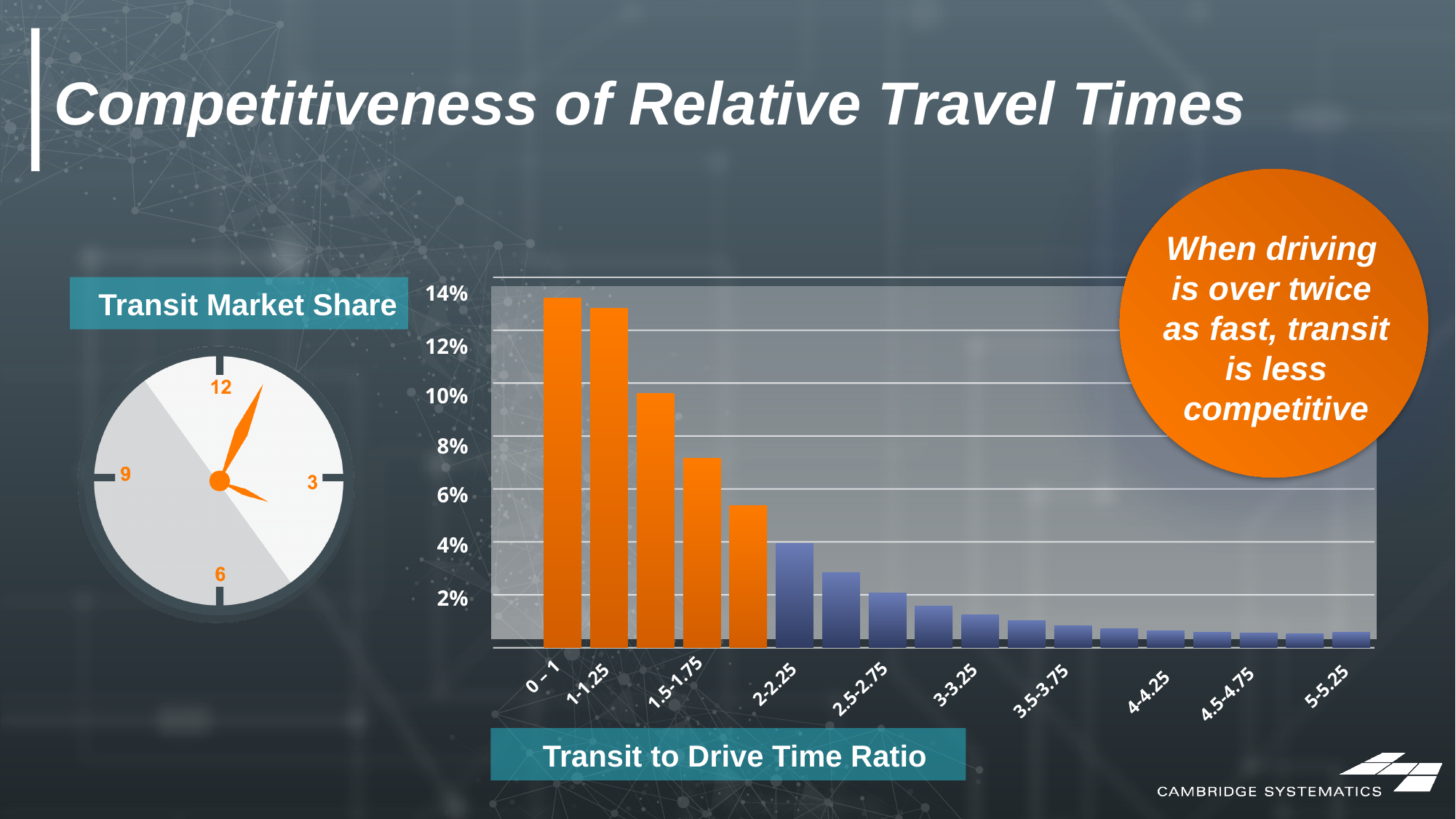
What kind of chart is shown on the slide? bar chart Is the transit market share for the 0 – 1 ratio category greater or less than 12%? greater Is the transit market share for the 1.5-1.75 ratio category greater or less than 8%? less What is the label on the x axis of the chart? Transit to Drive Time Ratio Do the bars rise or fall as the transit to drive time ratio increases along the x axis? fall Is the transit market share for the 2-2.25 ratio category greater or less than 6%? less Which has a higher transit market share, the 1.5-1.75 category or the 3-3.25 category? 1.5-1.75 How many bars in the chart are coloured orange? 5 Which transit to drive time ratio category has the highest transit market share? 0 – 1 Which has a higher transit market share, the 0 – 1 category or the 2-2.25 category? 0 – 1